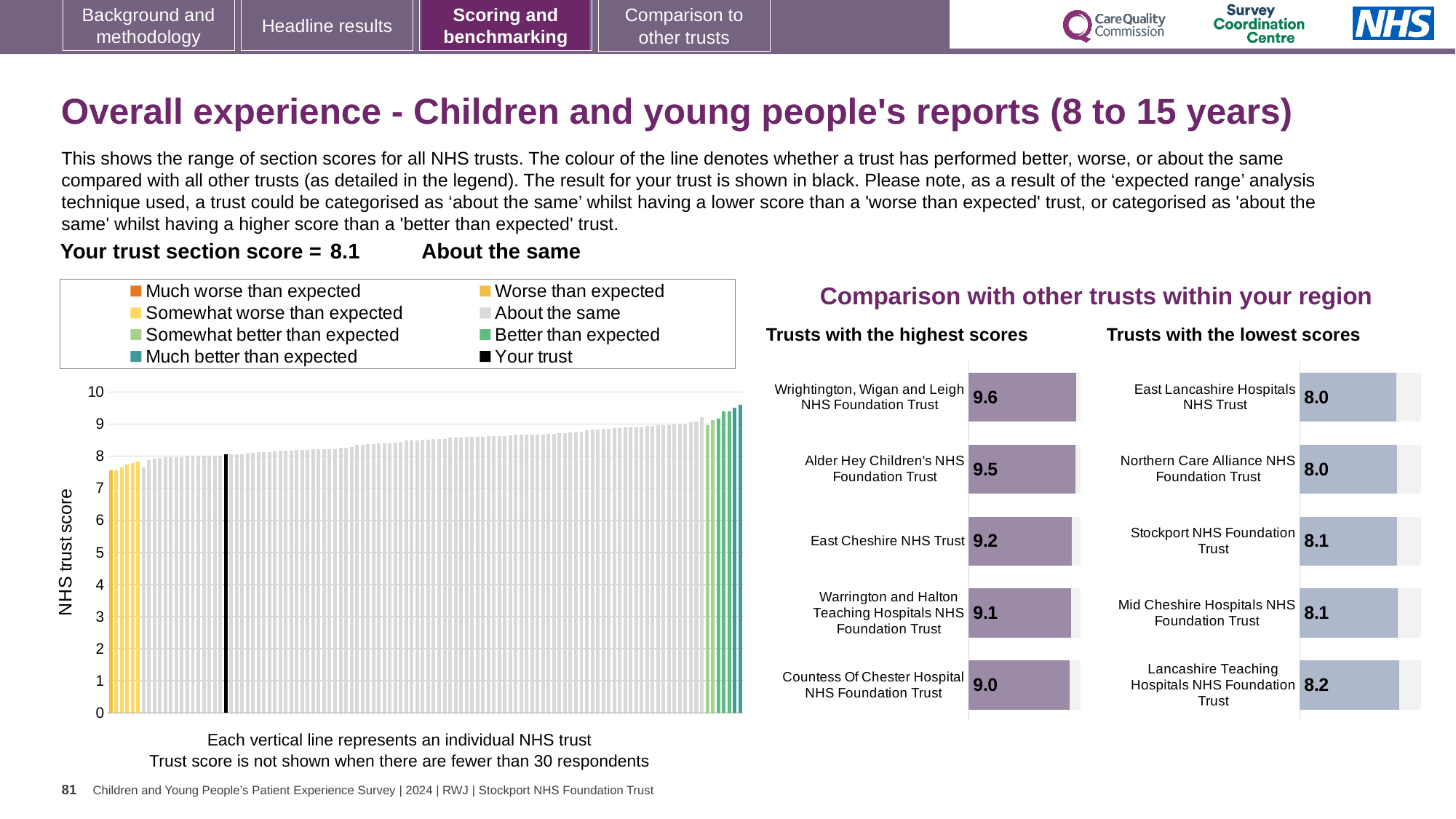
In the main chart on the left, what is the section score for your trust (the black bar)? 8.1 In the 'Trusts with the highest scores' chart, which trust has the lowest score? Countess Of Chester Hospital NHS Foundation Trust How many trusts are shown in the 'Trusts with the lowest scores' chart? 5 In the 'Trusts with the highest scores' chart, what is the difference between the scores of Wrightington, Wigan and Leigh NHS Foundation Trust and Countess Of Chester Hospital NHS Foundation Trust? 0.6 In the 'Trusts with the lowest scores' chart, which has the higher score: Stockport NHS Foundation Trust or East Lancashire Hospitals NHS Trust? Stockport NHS Foundation Trust In the main chart on the left, do the trust scores rise or fall from left to right? rise In the 'Trusts with the highest scores' chart, what is the score for East Cheshire NHS Trust? 9.2 In the 'Trusts with the highest scores' chart, what is the score for Wrightington, Wigan and Leigh NHS Foundation Trust? 9.6 In the main chart on the left, is the value for your trust (the black bar) greater or less than 9? less How many entries does the legend of the main chart on the left list? 8 In the 'Trusts with the lowest scores' chart, what is the score for Lancashire Teaching Hospitals NHS Foundation Trust? 8.2 In the 'Trusts with the highest scores' chart, which trust has the highest score? Wrightington, Wigan and Leigh NHS Foundation Trust